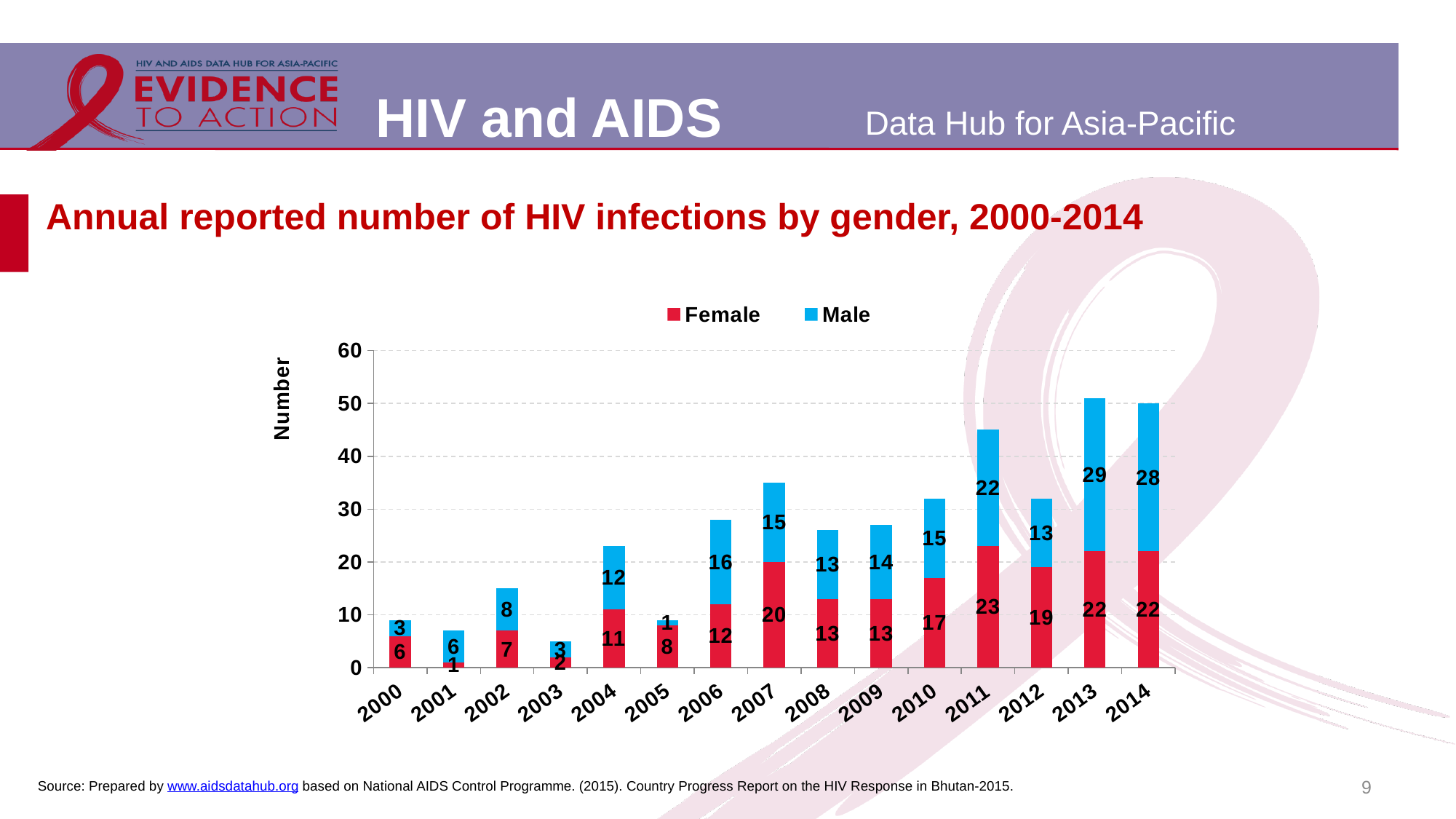
What kind of chart is shown on the slide? Stacked bar chart What is the Female value for 2001? 1 What is the Male value for 2013? 29 What is the total of the stacked bar for 2004? 23 How many years are shown on the x axis? 15 What is the total of the stacked bar for 2011? 45 Which is larger in 2006, the Female value or the Male value? Male What is the Female value for 2007? 20 What is the difference between the Male value for 2014 and the Male value for 2012? 15 How many series does the legend list? 2 Which year has the highest Male value? 2013 Which year has the lowest Female value? 2001